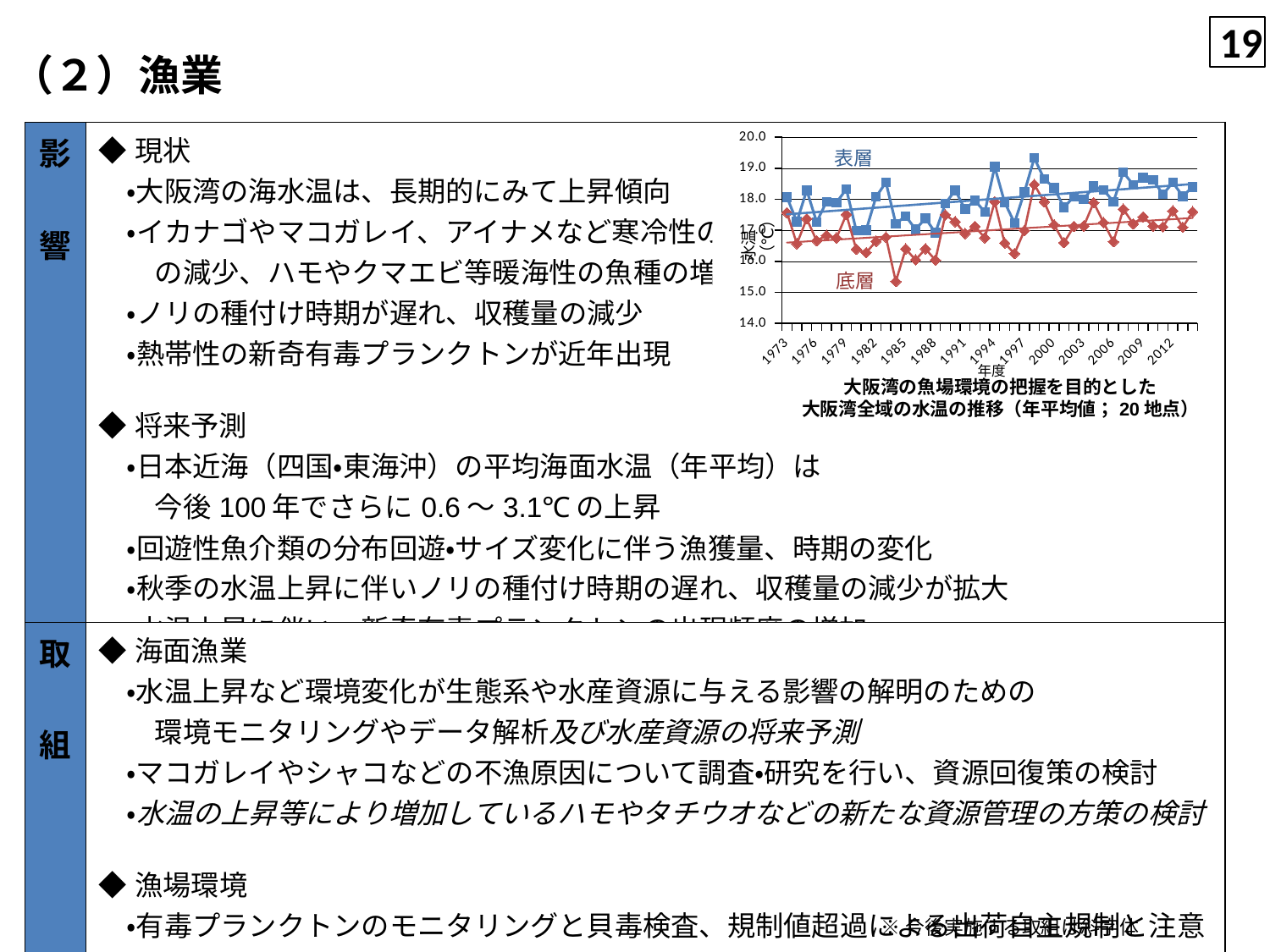
What is the highest value shown on the y axis of the chart? 20.0 Is the value for 底層 in 1973 greater or less than 18.0? less What are the names of the two series plotted in the chart? 表層 and 底層 What is the lowest value shown on the y axis of the chart? 14.0 Over the years shown on the x axis, do the water temperatures in the chart generally rise or fall? rise What is the first year shown on the x axis of the chart? 1973 How many data series are plotted in the water temperature chart? 2 Which series is drawn in blue in the chart? 表層 Is the value for 底層 in 1985 greater or less than 17.0? less Which series has the higher values throughout the chart, 表層 or 底層? 表層 What kind of chart is shown on the slide? line chart Is the value for 表層 in 2000 greater or less than 18.0? greater